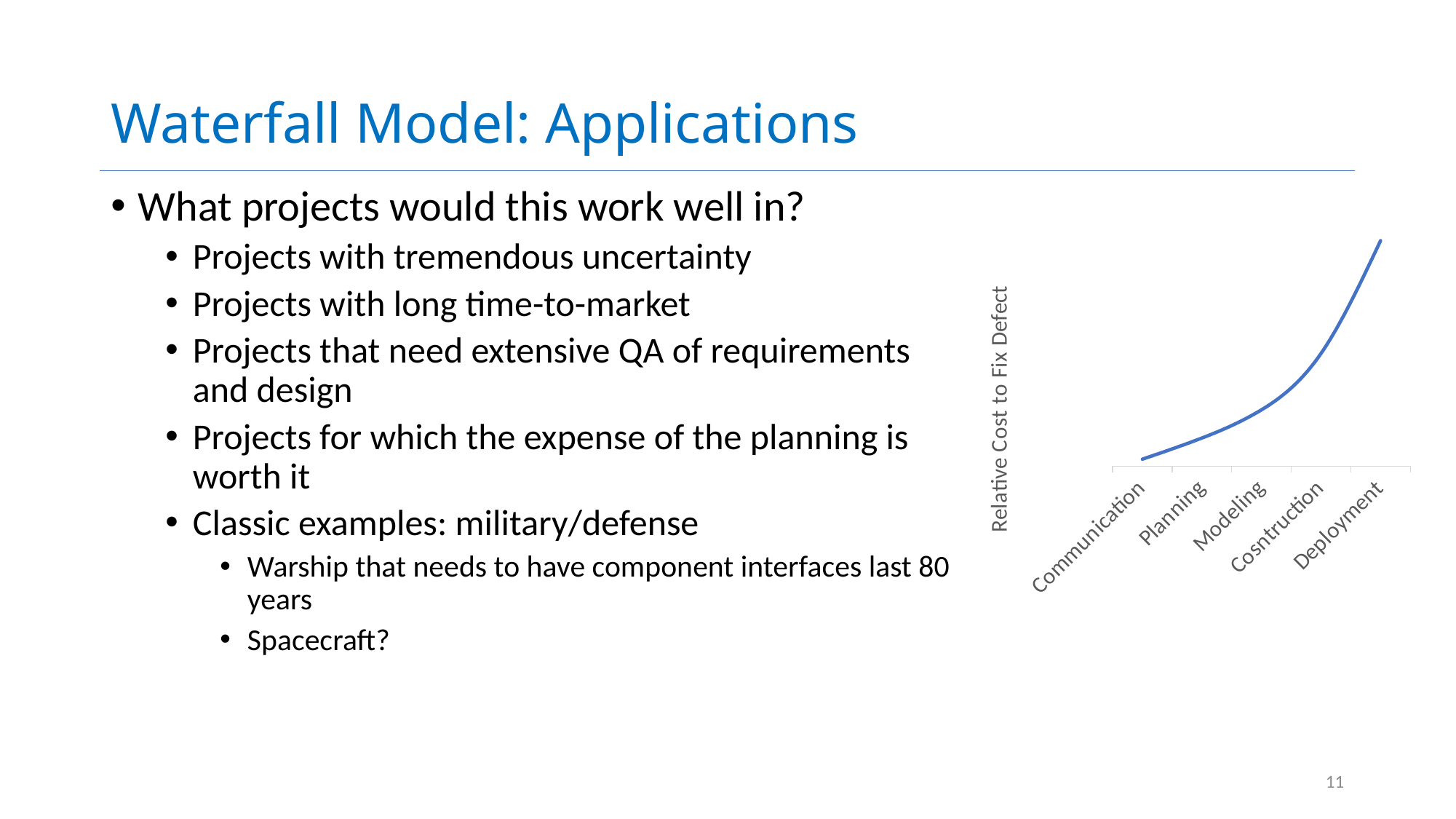
Which category has the highest relative cost to fix a defect? Deployment Which has a higher relative cost to fix a defect, Planning or Construction? Cosntruction Which category comes immediately after Modeling on the x axis? Cosntruction Which has a lower relative cost to fix a defect, Modeling or Deployment? Modeling What kind of chart is shown on the slide? line chart How many categories are shown on the x axis of the chart? 5 Do the values rise or fall from Communication to Deployment? rise What is the first category on the x axis of the chart? Communication Which category has the lowest relative cost to fix a defect? Communication What is the label on the vertical axis of the chart? Relative Cost to Fix Defect